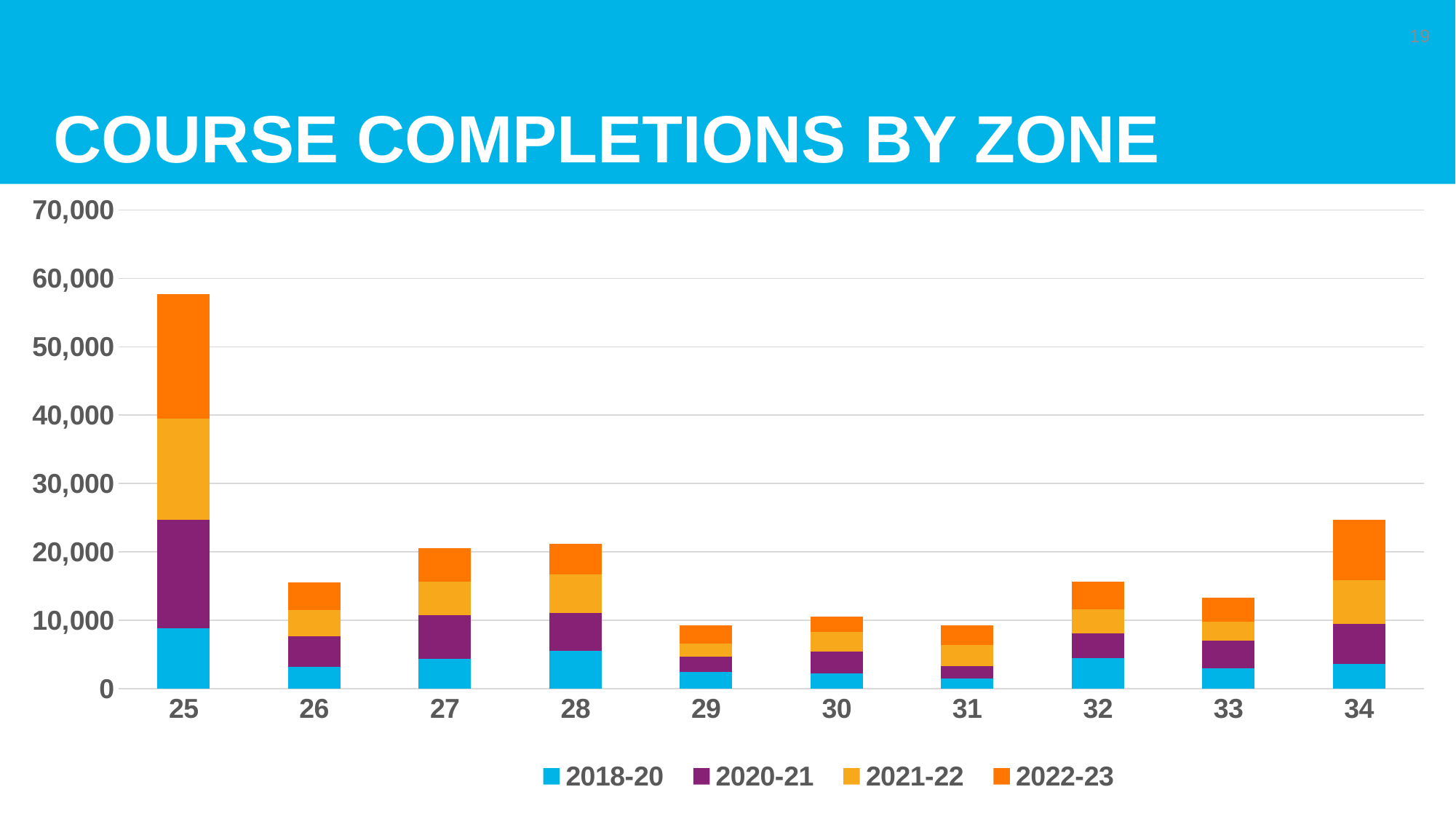
How many series does the legend list? 4 Is the total for zone 29 greater or less than 10,000? less Which zone has the larger total, zone 27 or zone 26? 27 Is the total for zone 26 greater or less than 20,000? less What is the title of the chart? COURSE COMPLETIONS BY ZONE Which zone has the larger total, zone 34 or zone 28? 34 What kind of chart is shown on the slide? Stacked bar chart Is the total for zone 34 greater or less than 20,000? greater How many zones are shown on the x axis? 10 Which zone has the highest total course completions? 25 Which series is listed first in the legend? 2018-20